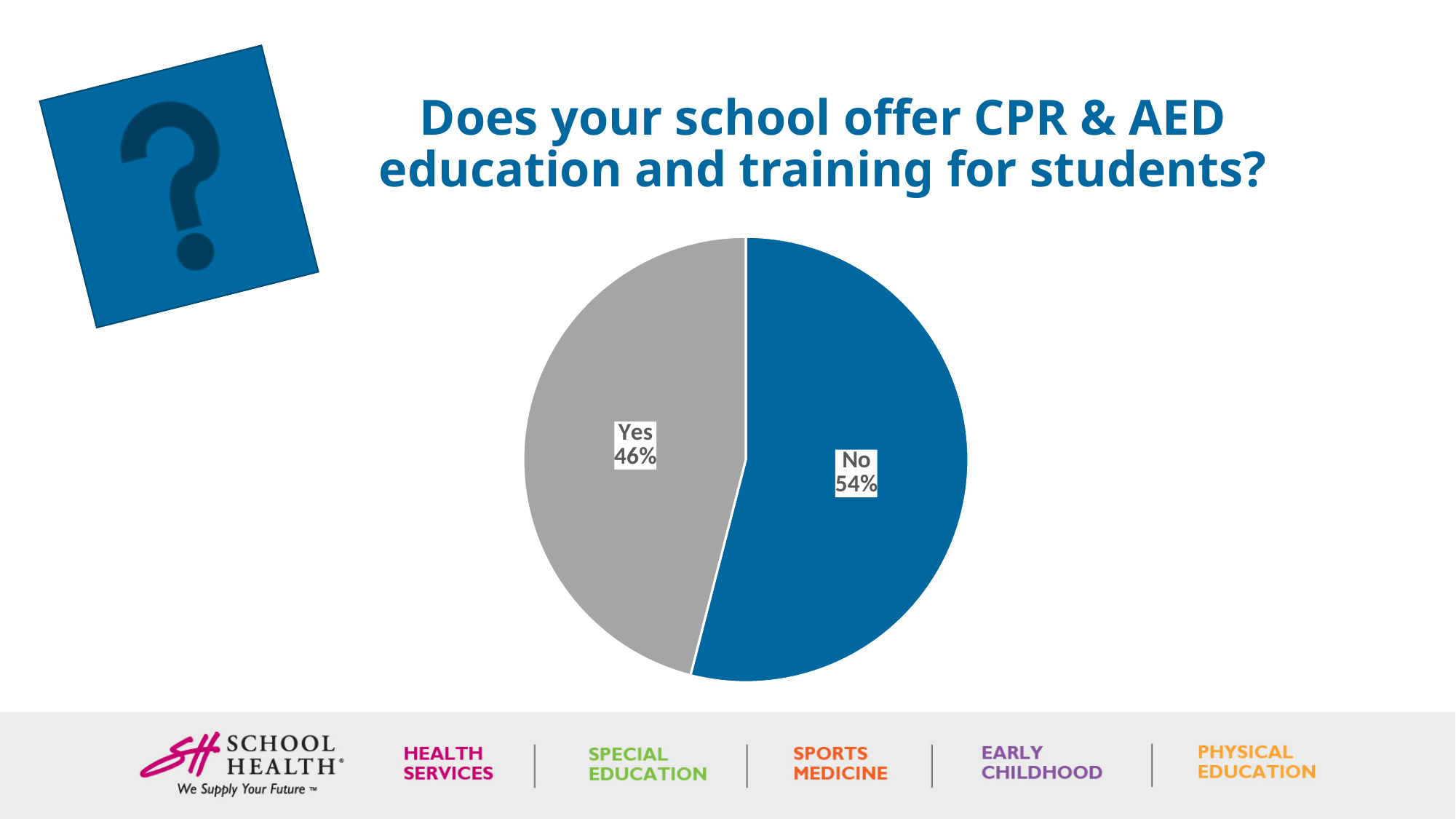
What is the difference in percentage points between the "No" and "Yes" slices? 8 What question does the chart title ask? Does your school offer CPR & AED education and training for students? What colour is the "Yes" slice? grey How many slices does the pie chart have? 2 What kind of chart is shown on the slide? pie chart Which response has the larger share of the pie? No What percentage of respondents answered "No"? 54% Is the share for "Yes" larger or smaller than the share for "No"? smaller What share of the pie does the "No" slice represent? 54% Which response has the smaller share of the pie? Yes What percentage of respondents answered "Yes"? 46%